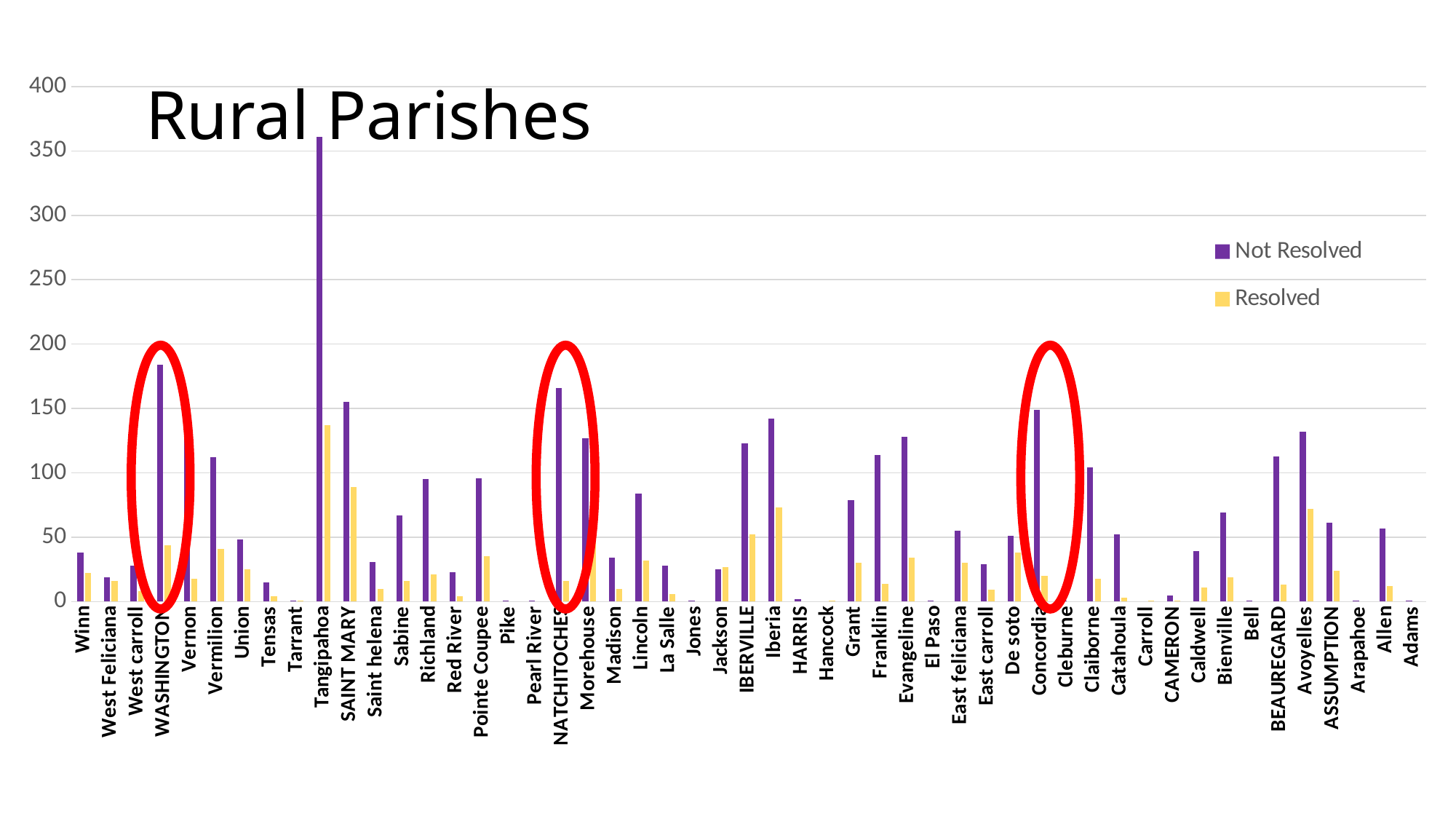
Which parish has the highest Resolved value? Tangipahoa Is the Not Resolved value for Concordia greater or less than 100? greater Is the Resolved value for SAINT MARY greater or less than 100? less Is the Not Resolved value for Tangipahoa greater or less than 350? greater Which parish has the highest Not Resolved value? Tangipahoa What is the title of the chart? Rural Parishes Which has the larger Not Resolved value, Iberia or IBERVILLE? Iberia How many series does the legend list? 2 What type of chart is shown on the slide? Bar chart Which has the larger Not Resolved value, WASHINGTON or NATCHITOCHES? WASHINGTON Which three parishes are circled in red on the chart? WASHINGTON, NATCHITOCHES, Concordia